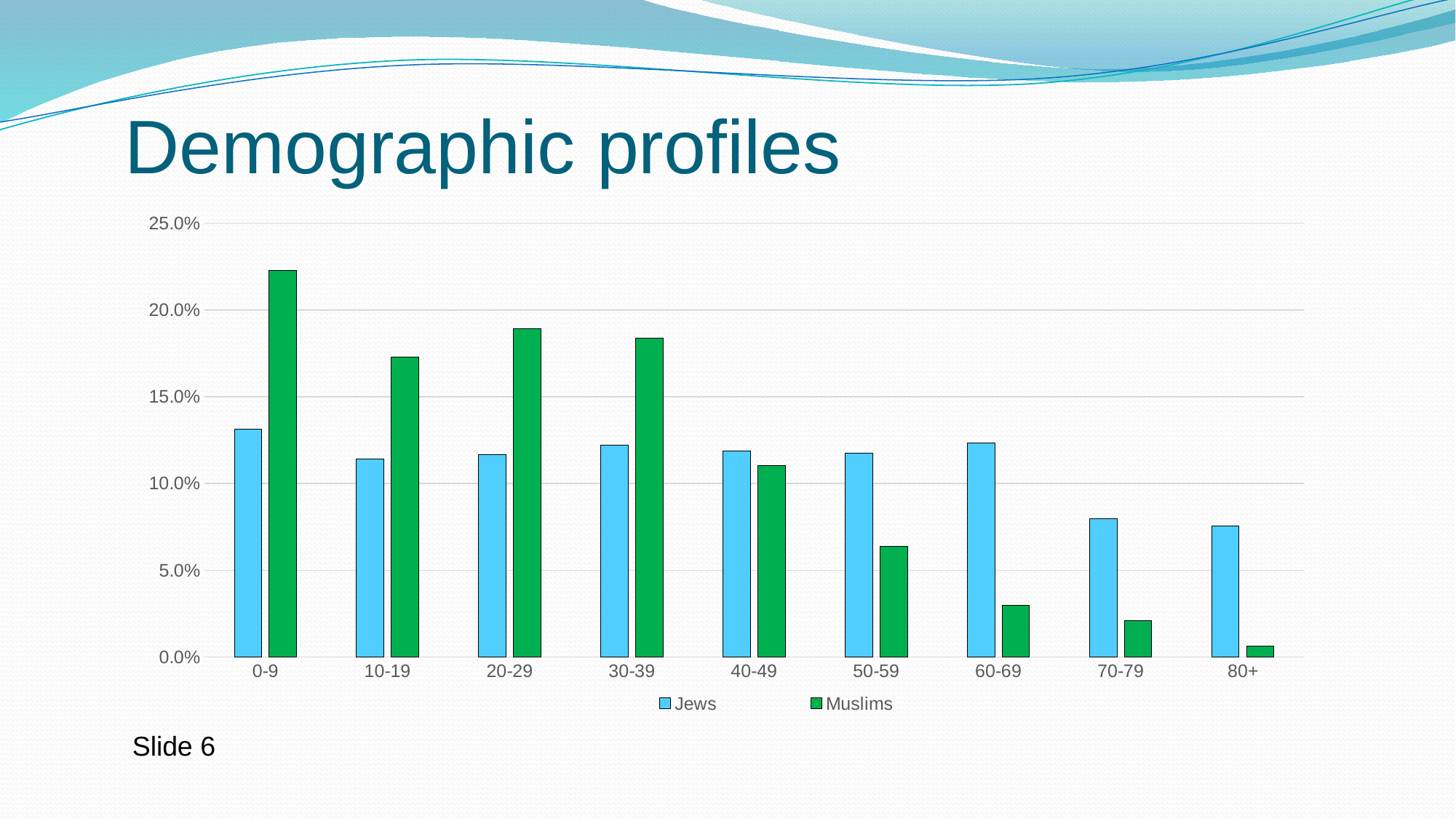
In the 60-69 age group, which series has the larger value, Jews or Muslims? Jews What kind of chart is shown on the slide? bar chart Which age group has the lowest value for Muslims? 80+ Is the value for Muslims in the 0-9 age group greater or less than 20.0%? greater Do the values for Muslims rise or fall from the 40-49 age group to the 80+ age group? fall Is the value for Jews in the 70-79 age group greater or less than 10.0%? less Which age group has the highest value for Jews? 0-9 What colour are the bars for the Muslims series? green How many age-group categories are shown on the x axis? 9 Which age group has the highest value for Muslims? 0-9 In the 0-9 age group, which series has the larger value, Jews or Muslims? Muslims How many series does the legend list? 2